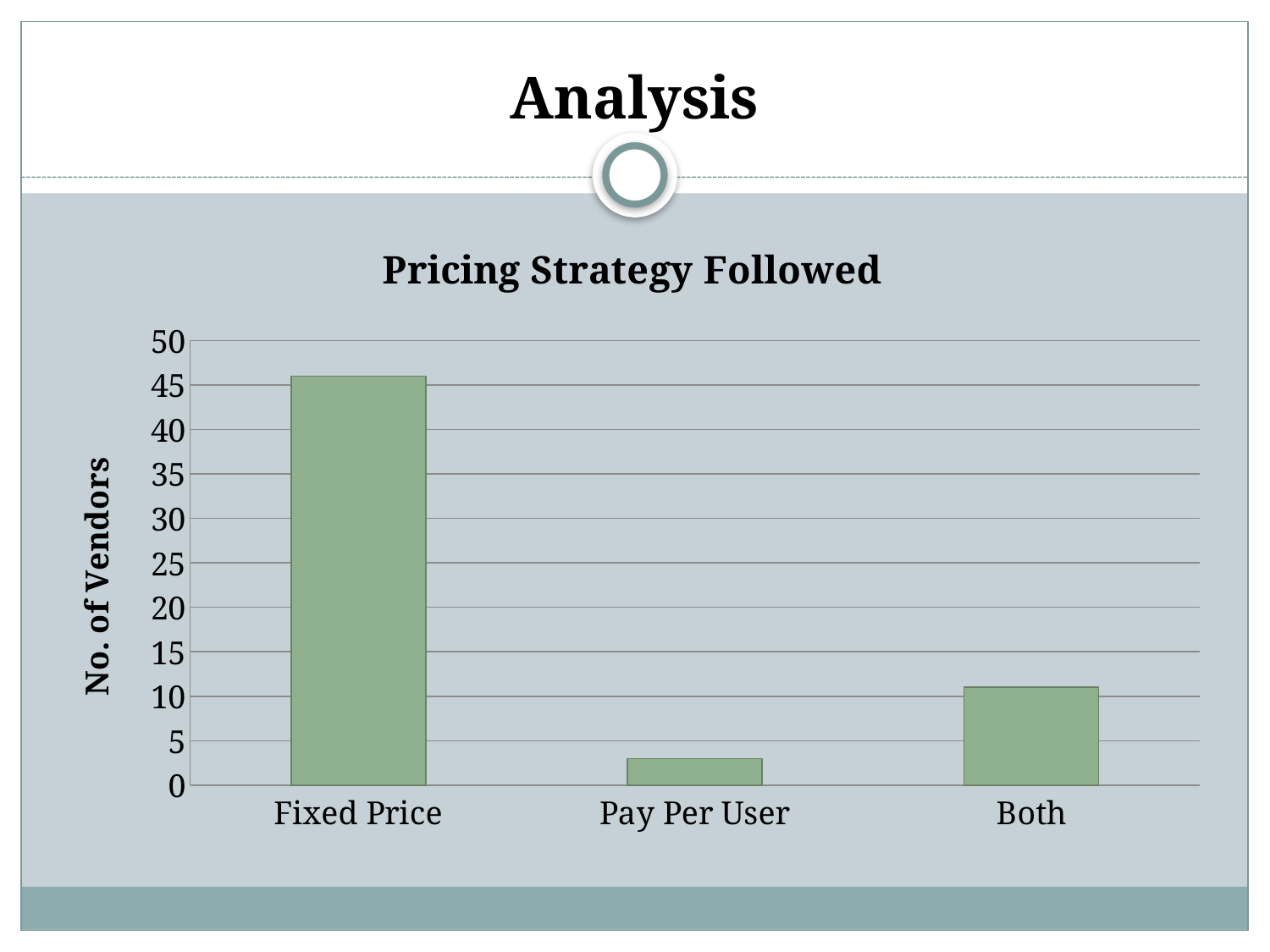
What kind of chart is shown on the slide? bar chart Which pricing strategy has the highest number of vendors? Fixed Price Which has more vendors, Both or Pay Per User? Both What is the title of the chart? Pricing Strategy Followed Which has more vendors, Fixed Price or Both? Fixed Price Is the value for Fixed Price greater or less than 40? greater Which pricing strategy has the lowest number of vendors? Pay Per User Is the value for Both greater or less than 15? less What is the label on the vertical axis of the chart? No. of Vendors Is the value for Pay Per User greater or less than 5? less How many pricing strategy categories are shown on the x axis? 3